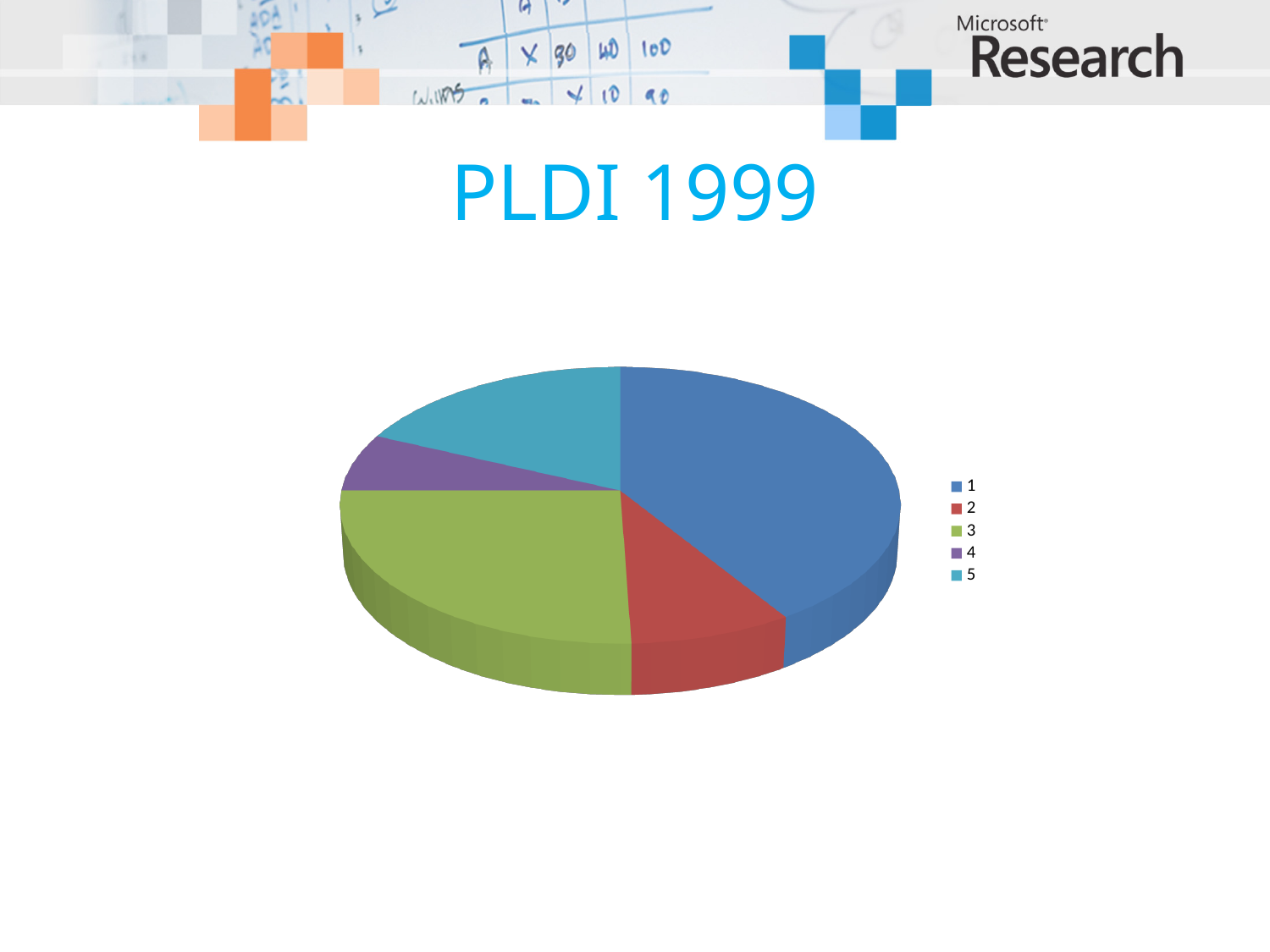
Which category has the largest slice of the pie? 1 How many entries does the legend list? 5 What colour is the slice for category 1 in the pie chart? blue How many slices does the pie chart have? 5 Which slice is larger, category 3 or category 4? 3 Which slice is larger, category 1 or category 2? 1 What is the title of the chart on the slide? PLDI 1999 Which category has the smallest slice of the pie? 4 What kind of chart is shown on the slide? pie chart Which slice is larger, category 2 or category 3? 3